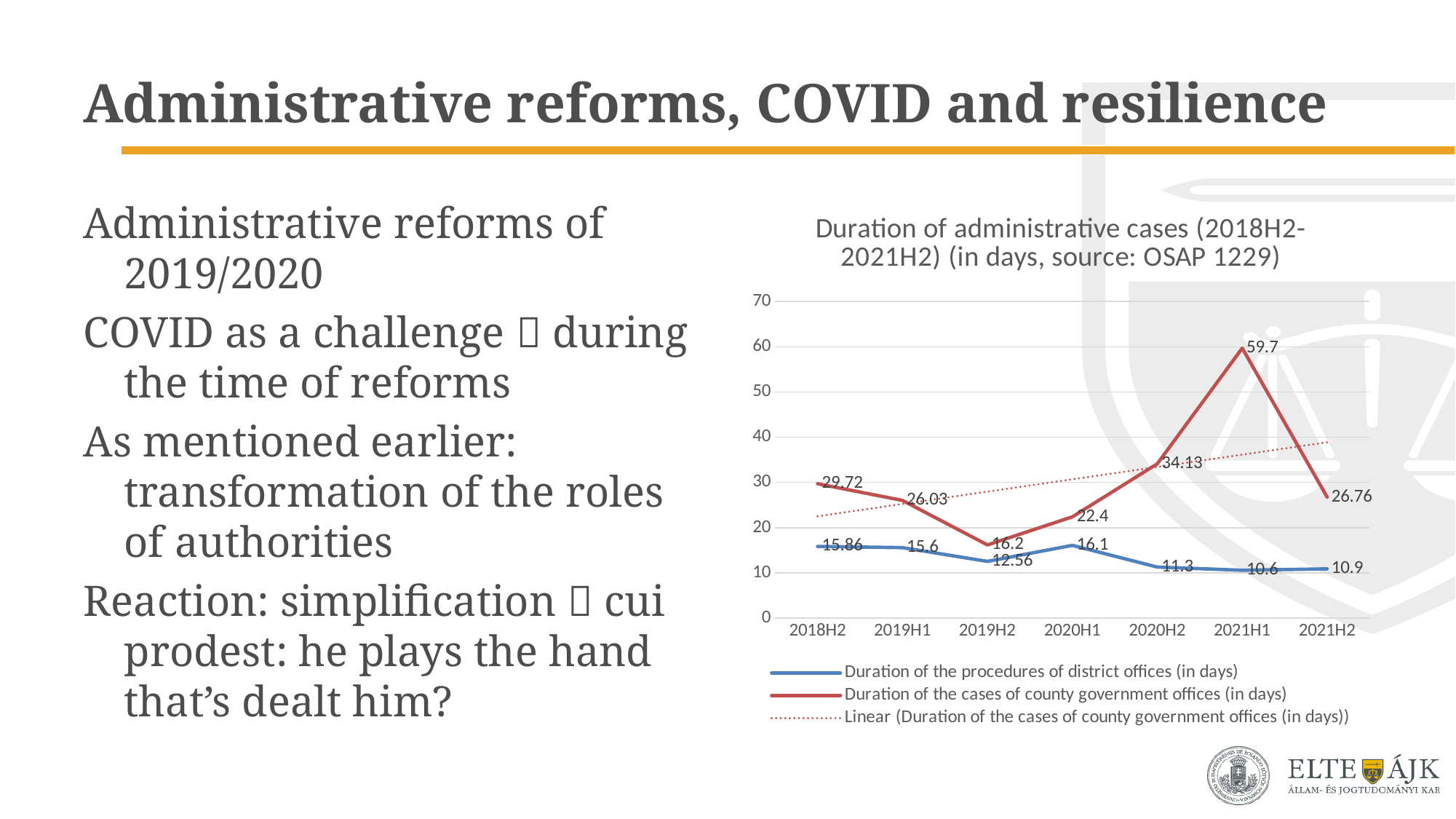
What is the duration of the procedures of district offices in 2018H2? 15.86 Which is larger in 2019H2: the duration of the cases of county government offices or the duration of the procedures of district offices? Duration of the cases of county government offices What type of chart is shown on the slide? line chart Does the duration of the procedures of district offices rise or fall from 2020H1 to 2021H1? fall What is the difference between the duration of the cases of county government offices in 2021H1 and in 2021H2? 32.94 In which period is the duration of the procedures of district offices lowest? 2021H1 Is the duration of the cases of county government offices in 2020H2 greater or less than 30? greater How many entries does the legend list? 3 How many time periods are shown on the x axis? 7 What is the title of the chart? Duration of administrative cases (2018H2-2021H2) (in days, source: OSAP 1229) In which period is the duration of the cases of county government offices highest? 2021H1 What is the duration of the cases of county government offices in 2021H1? 59.7